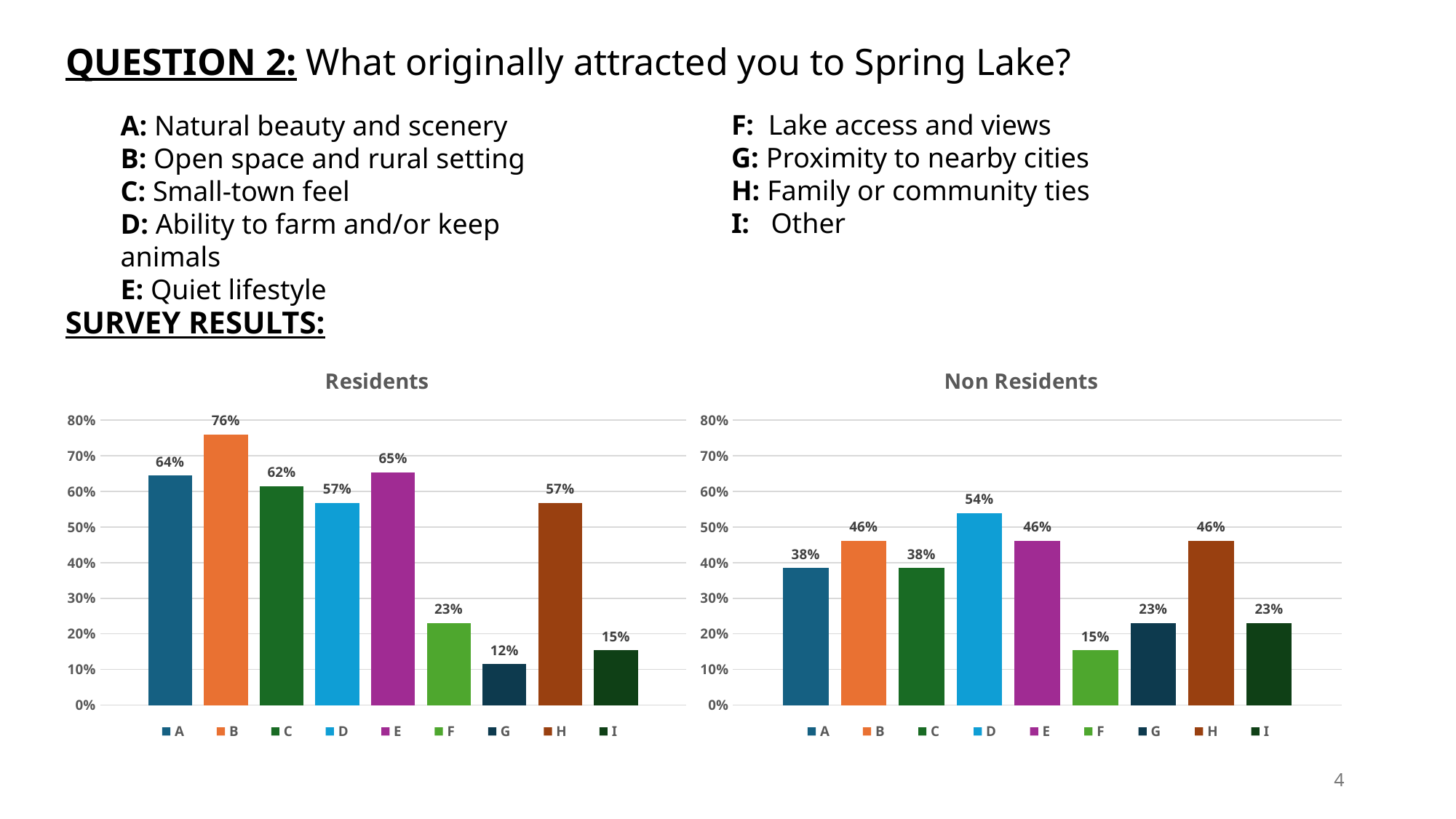
In the Residents chart, what is the value for category B? 76% In the Residents chart, which category has the highest value? B What kind of chart is the Residents chart? Bar chart How many categories are shown in the Non Residents chart? 9 In the Non Residents chart, what is the value for category D? 54% In the Residents chart, which category has the lowest value? G In the Residents chart, what is the difference between the values for B and G? 64% In the Non Residents chart, which category has the highest value? D In the Non Residents chart, what is the value for category F? 15% In the Non Residents chart, what is the difference between the values for D and A? 16% In the Non Residents chart, which category has the lowest value? F In the Residents chart, which is larger, the value for E or the value for H? E